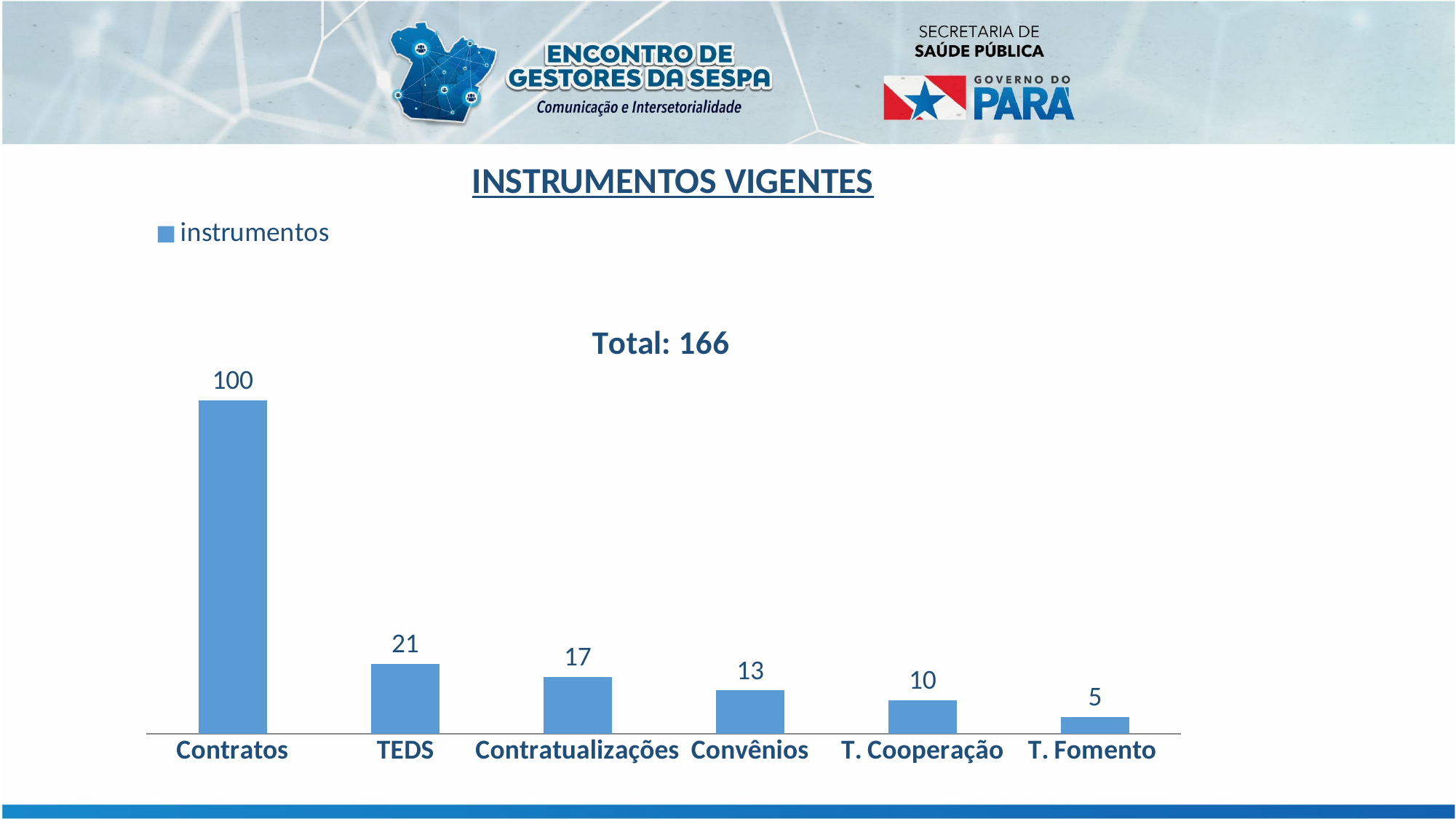
What is the value for Convênios? 13 Which category has the lowest value? T. Fomento What is the difference between the values for Contratualizações and T. Cooperação? 7 Which is larger, the value for Convênios or the value for T. Cooperação? Convênios What is the difference between the values for Contratos and TEDS? 79 How many categories are shown on the x axis? 6 Which category has the highest value? Contratos What is the value for TEDS? 21 What is the value for T. Fomento? 5 What is the value for Contratos? 100 What kind of chart is shown on the slide? Bar chart What total is printed above the chart? Total: 166